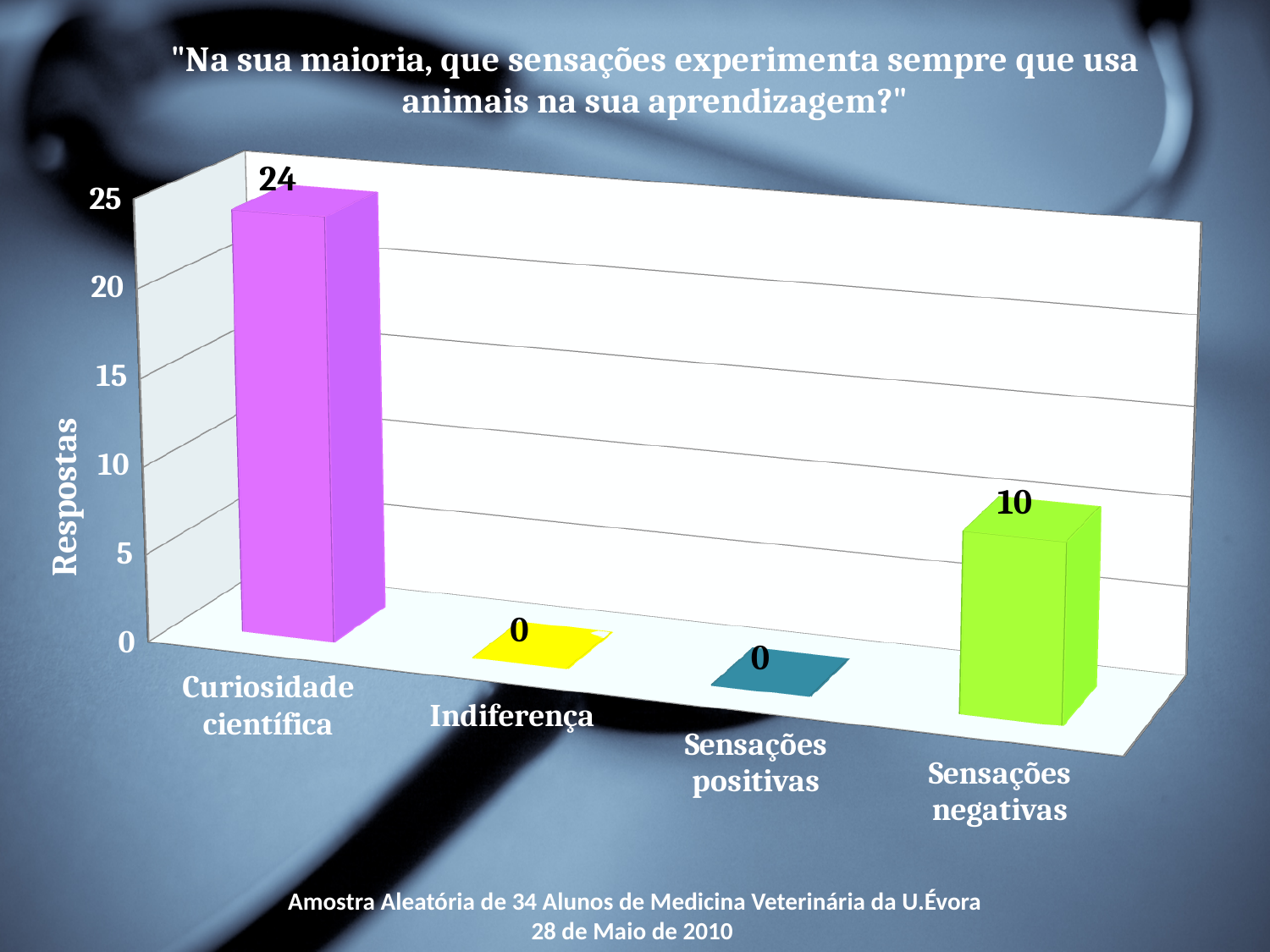
Which is larger, the value for Sensações negativas or the value for Indiferença? Sensações negativas What is the label of the vertical axis? Respostas How many categories are shown on the x axis? 4 What is the value for Sensações positivas? 0 What colour is the bar for Sensações negativas? green What is the difference between the values for Curiosidade científica and Sensações negativas? 14 What is the value for Sensações negativas? 10 What is the value for Indiferença? 0 What kind of chart is shown on the slide? bar chart What is the value for Curiosidade científica? 24 Is the value for Curiosidade científica greater or less than 20? greater Which category has the highest value? Curiosidade científica